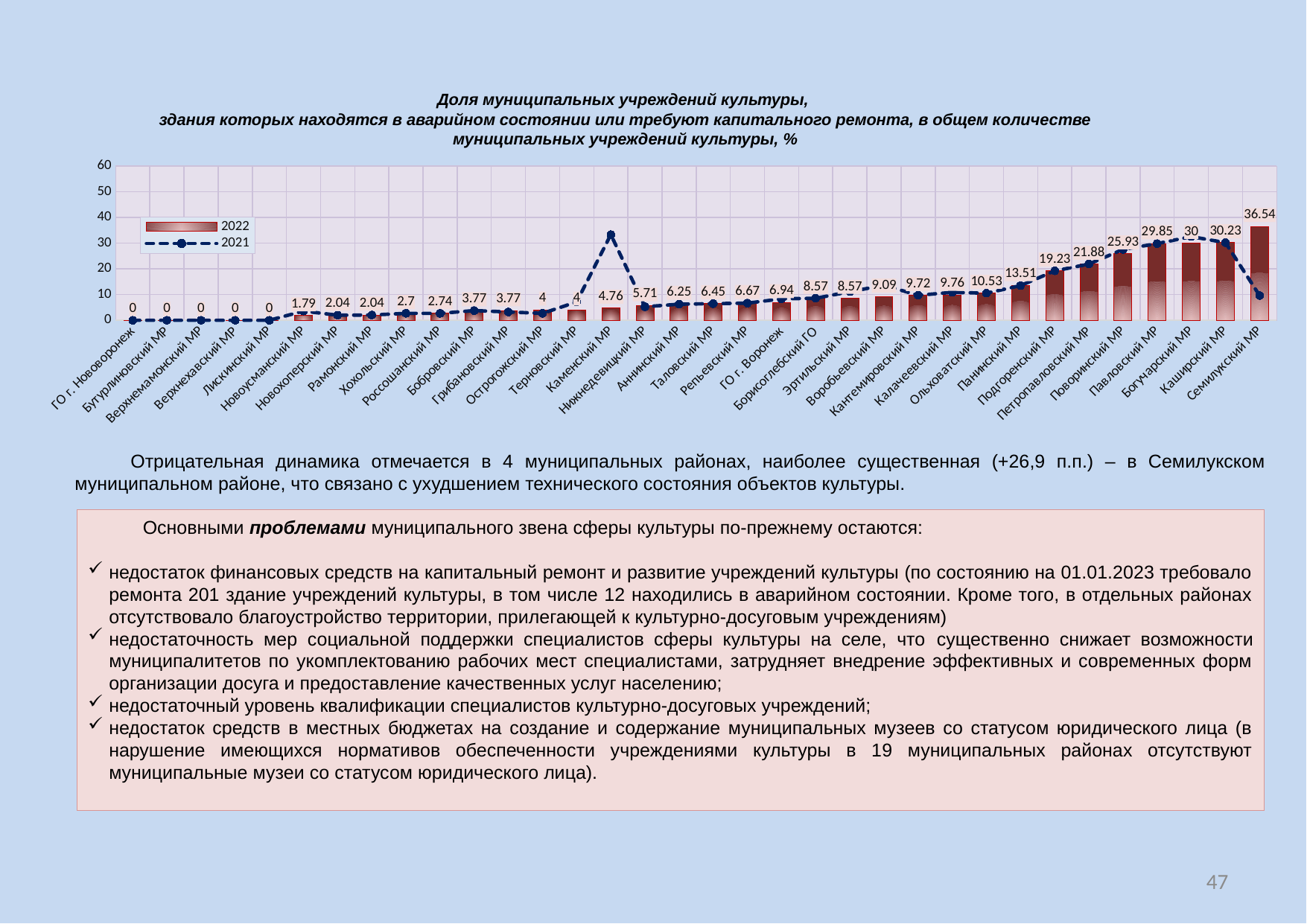
Which has the larger 2022 value, Павловский МР or Поворинский МР? Павловский МР Is the 2021 value for Каменский МР greater or less than 30? greater What is the 2022 value for Семилукский МР? 36.54 What is the 2022 value for Богучарский МР? 30 What is the difference between the 2022 values for Семилукский МР and Каширский МР? 6.31 What kind of chart is used for the 2022 series? Bar chart How many series does the legend list? 2 Is the 2021 value for Семилукский МР greater or less than 20? less What is the 2022 value for Подгоренский МР? 19.23 Do the 2022 values generally rise or fall from left to right along the x axis? Rise Which category has the highest 2022 value? Семилукский МР What is the 2022 value for Новоусманский МР? 1.79